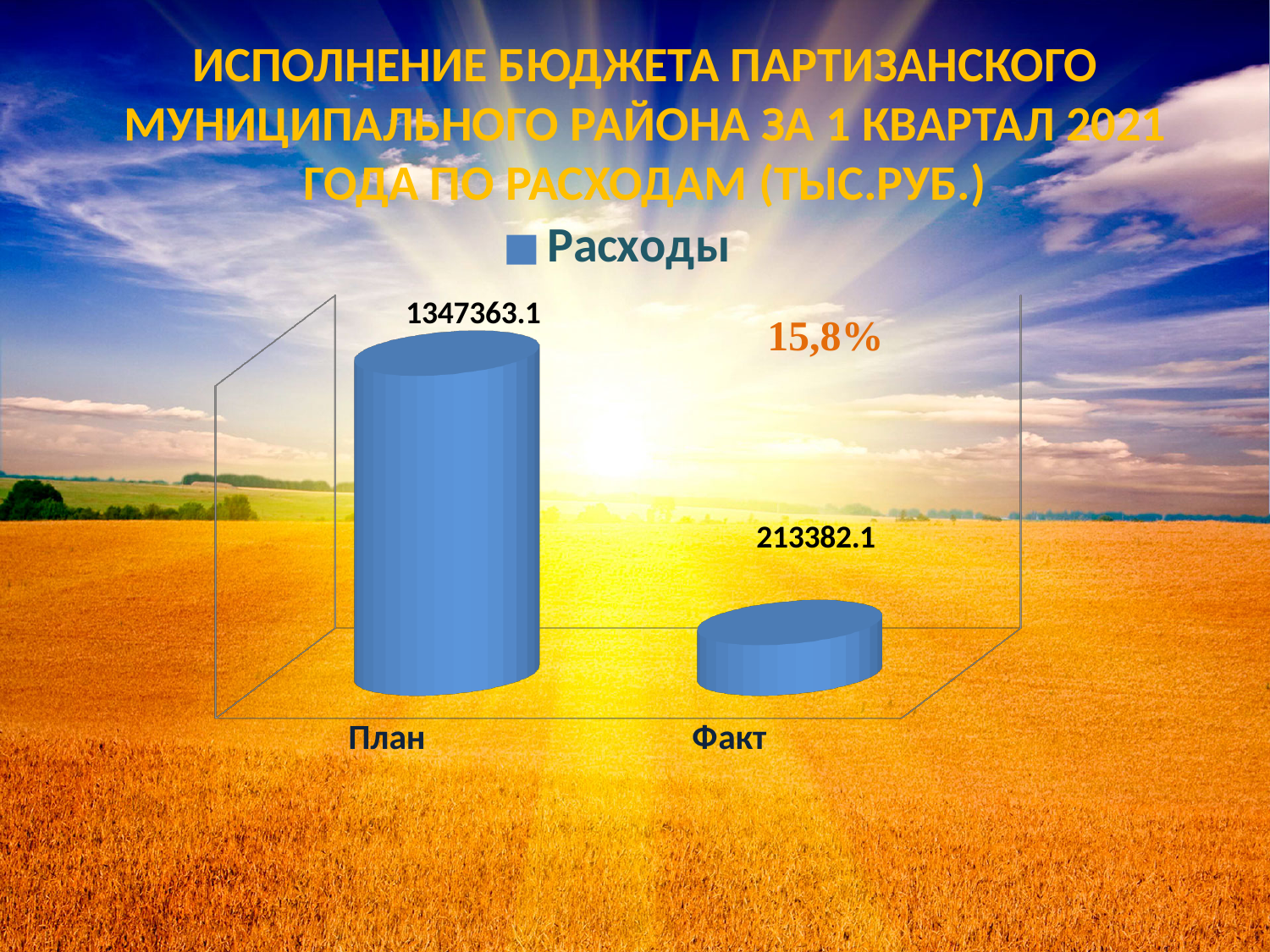
Do the values rise or fall from План to Факт? Fall What is the value for План? 1347363.1 What series name is shown in the chart legend? Расходы Which is larger, the value for План or the value for Факт? План How many categories are shown on the chart? 2 What is the difference between the values for План and Факт? 1133981.0 What percentage is annotated on the chart above the Факт bar? 15,8% How many series does the legend list? 1 Which category has the highest value? План Which category has the lowest value? Факт What kind of chart is shown on the slide? Bar chart What is the value for Факт? 213382.1